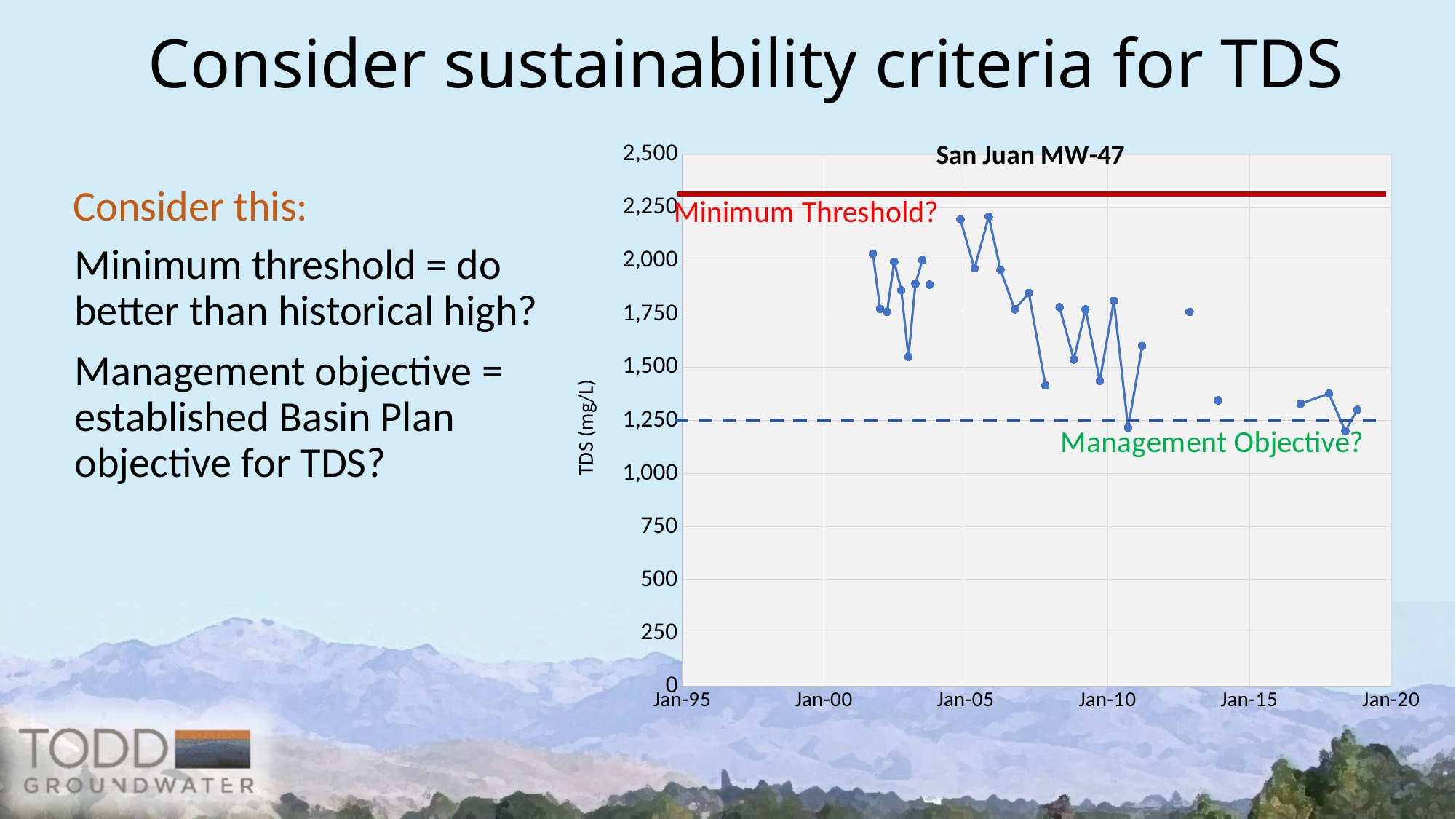
Overall, do the TDS values rise or fall from Jan-00 to Jan-20? fall What kind of chart is shown on the slide? line chart What is the highest value shown on the vertical axis of the chart? 2,500 What is the label of the vertical axis of the chart? TDS (mg/L) Is the lowest TDS value plotted near Jan-18 greater or less than 1,500? less Which is larger: the TDS value plotted just after Jan-05 or the TDS value plotted around Jan-15? the value just after Jan-05 At what TDS value is the dashed Management Objective line drawn? 1,250 What is the earliest date label on the horizontal axis of the chart? Jan-95 What is the title of the chart? San Juan MW-47 Is the TDS value plotted around Jan-13 greater or less than 1,500? greater Is the TDS value plotted around Jan-15 greater or less than 1,500? less